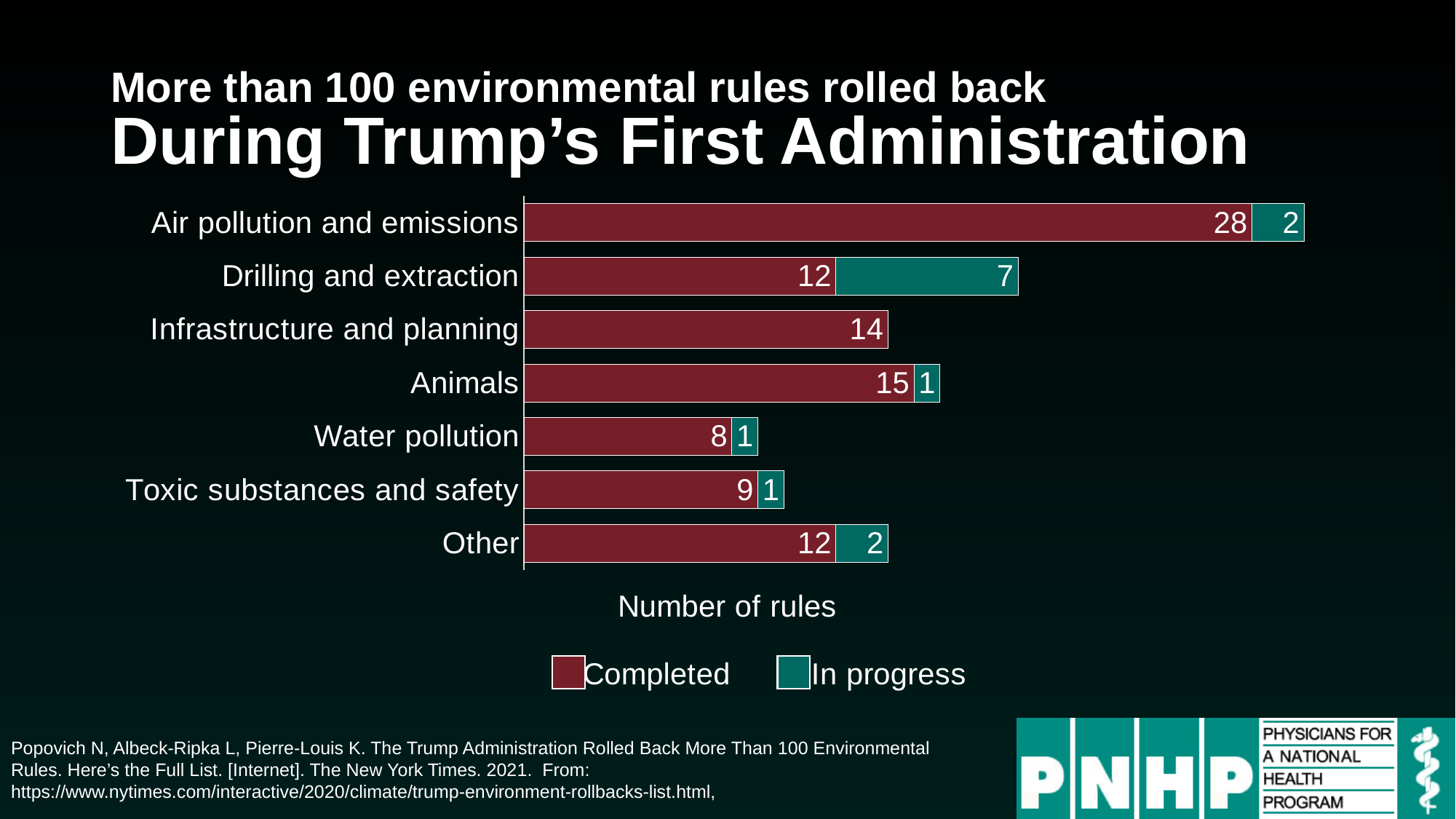
How many Completed rules are shown for Infrastructure and planning? 14 What is the difference between the Completed rules for Air pollution and emissions and for Animals? 13 How many Completed rules are shown for Air pollution and emissions? 28 What is the total number of rules (Completed plus In progress) for Air pollution and emissions? 30 How many series does the legend list? 2 What is the total number of rules (Completed plus In progress) for Drilling and extraction? 19 Which category has the lowest number of Completed rules? Water pollution How many categories are shown on the chart? 7 Which category has the highest number of Completed rules? Air pollution and emissions What kind of chart is shown on the slide? Stacked bar chart Which has more Completed rules, Drilling and extraction or Infrastructure and planning? Infrastructure and planning How many In progress rules are shown for Drilling and extraction? 7